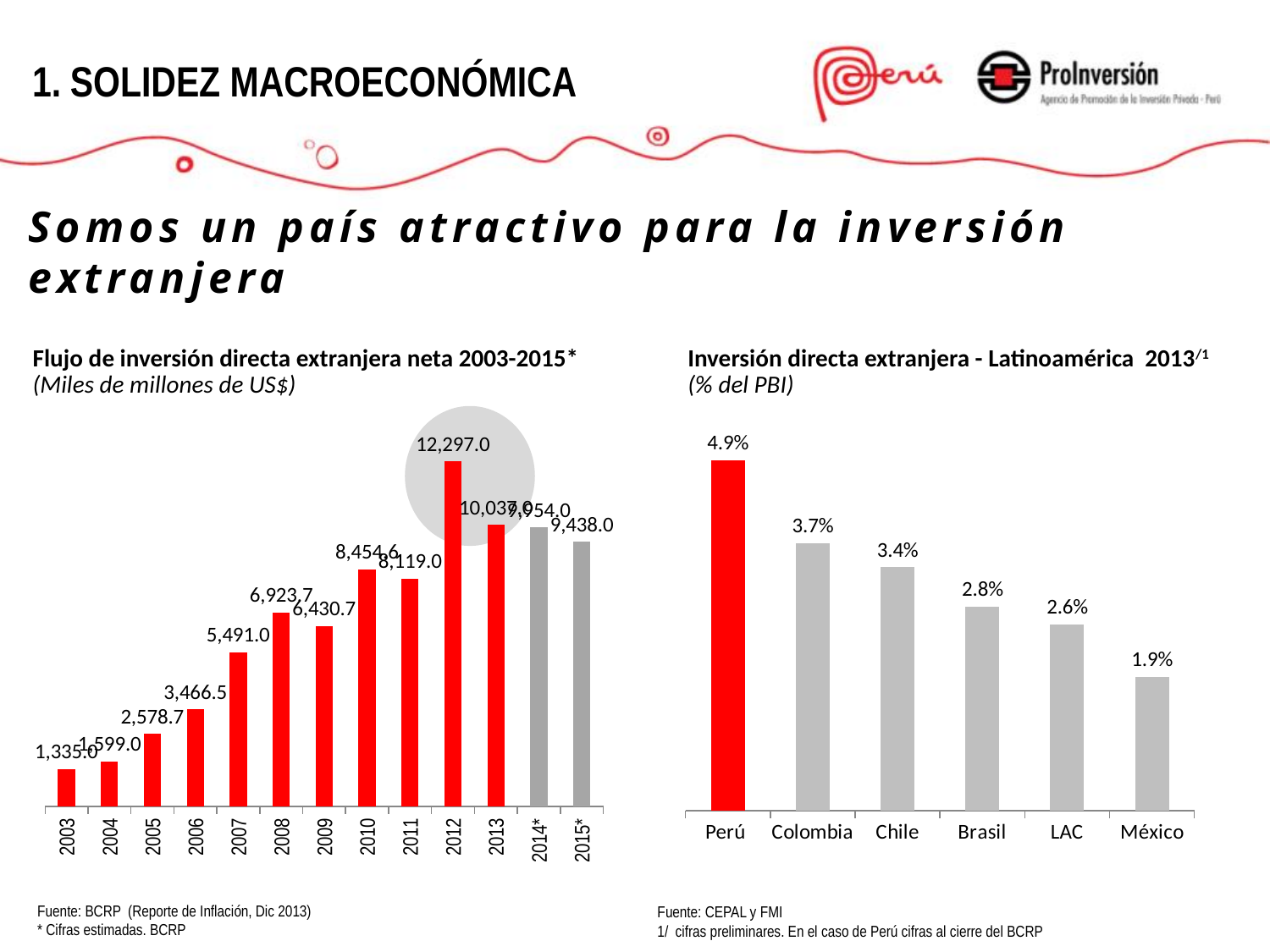
In the chart 'Inversión directa extranjera - Latinoamérica 2013', which country has the highest value? Perú In the chart 'Inversión directa extranjera - Latinoamérica 2013', how many categories are shown? 6 What kind of chart is 'Flujo de inversión directa extranjera neta 2003-2015*'? bar chart In the chart 'Inversión directa extranjera - Latinoamérica 2013', what is the value for Perú? 4.9% In the chart 'Flujo de inversión directa extranjera neta 2003-2015*', do the values rise or fall from 2003 to 2007? rise In the chart 'Inversión directa extranjera - Latinoamérica 2013', which is larger, Chile or Brasil? Chile In the chart 'Flujo de inversión directa extranjera neta 2003-2015*', which year has the lowest value? 2003 In the chart 'Flujo de inversión directa extranjera neta 2003-2015*', which year has the highest value? 2012 In the chart 'Flujo de inversión directa extranjera neta 2003-2015*', what is the value for 2007? 5,491.0 In the chart 'Inversión directa extranjera - Latinoamérica 2013', what is the difference between the values for Perú and Colombia? 1.2% In the chart 'Flujo de inversión directa extranjera neta 2003-2015*', what is the value for 2012? 12,297.0 In the chart 'Inversión directa extranjera - Latinoamérica 2013', which category has the lowest value? México